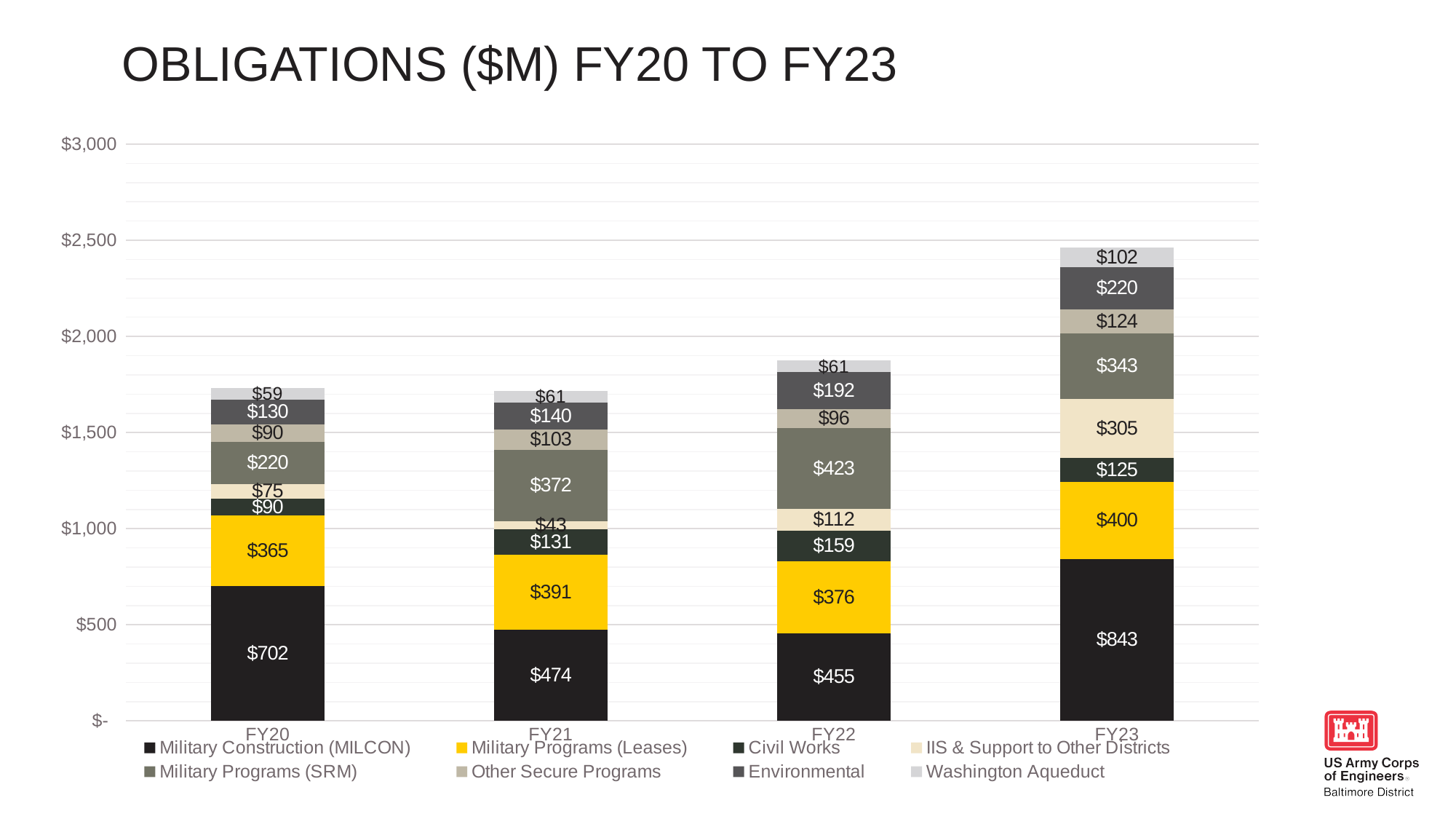
In which fiscal year is the Military Construction (MILCON) value highest? FY23 What kind of chart is shown on the slide? Stacked bar chart What is the value for Military Programs (SRM) in FY22? $423 What is the total of the FY23 stacked bar? $2,462 Is the total of the FY23 stacked bar greater or less than $2,000? greater What is the difference between the Environmental value in FY23 and in FY20? $90 In which fiscal year is the Civil Works value lowest? FY20 Which is larger, the Military Programs (Leases) value in FY21 or in FY22? FY21 How many series does the legend list? 8 How many fiscal years are shown on the x axis? 4 What is the value for Washington Aqueduct in FY20? $59 What is the value for Military Construction (MILCON) in FY23? $843